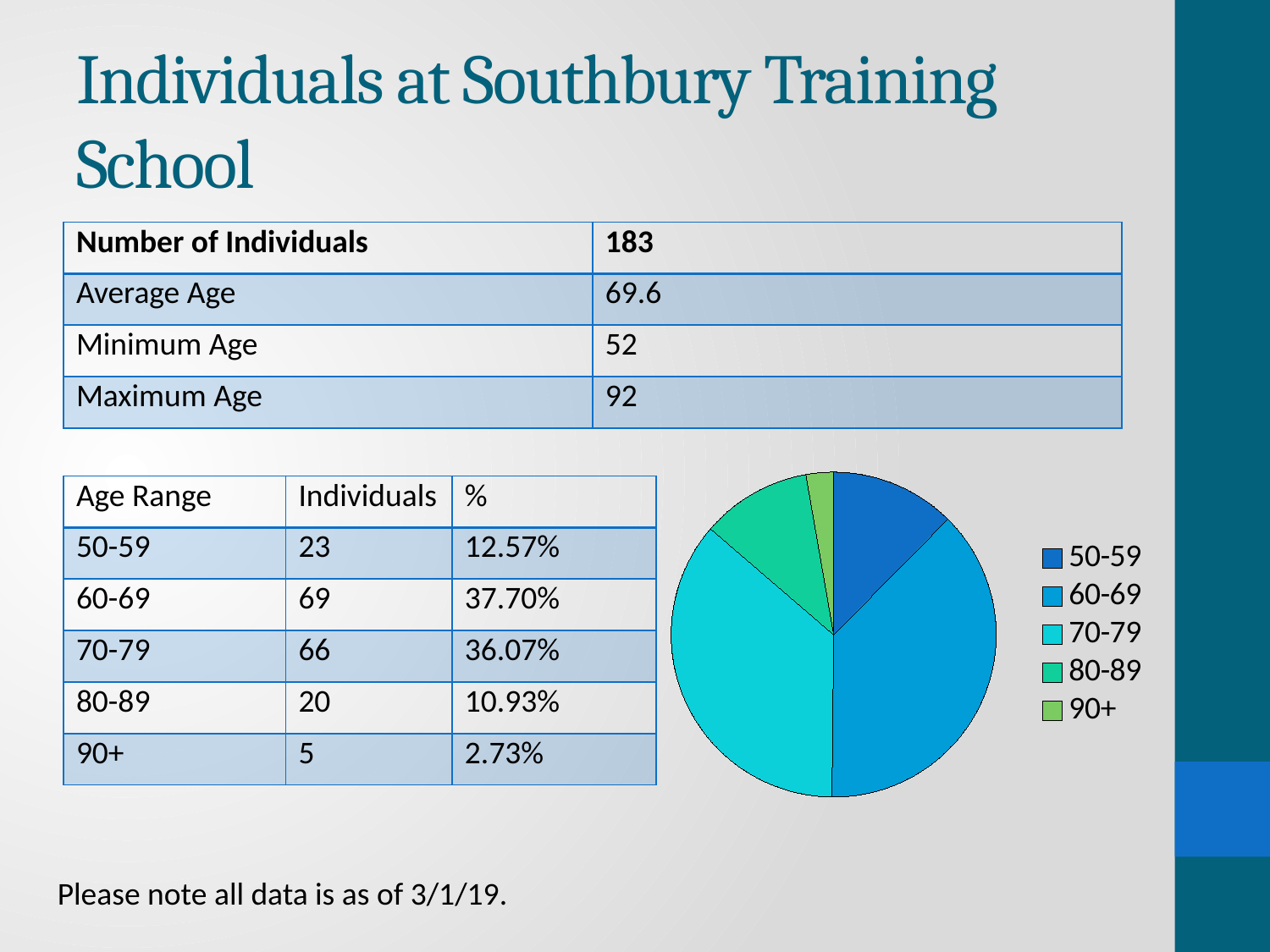
What kind of chart is shown on the slide? pie chart Which legend entry of the pie chart is shown in light green? 90+ What share of the pie does the 70-79 age range represent? 36.07% What share of the pie does the 50-59 age range represent? 12.57% How many individuals are in the 80-89 age range shown in the pie chart? 20 How many entries does the pie chart's legend list? 5 How many slices does the pie chart have? 5 What is the difference in the number of individuals between the 60-69 and 70-79 age ranges? 3 Which age range has the largest slice of the pie chart? 60-69 How many individuals are in the 90+ age range shown in the pie chart? 5 Which age range has the smallest slice of the pie chart? 90+ Which slice is larger in the pie chart, 50-59 or 80-89? 50-59